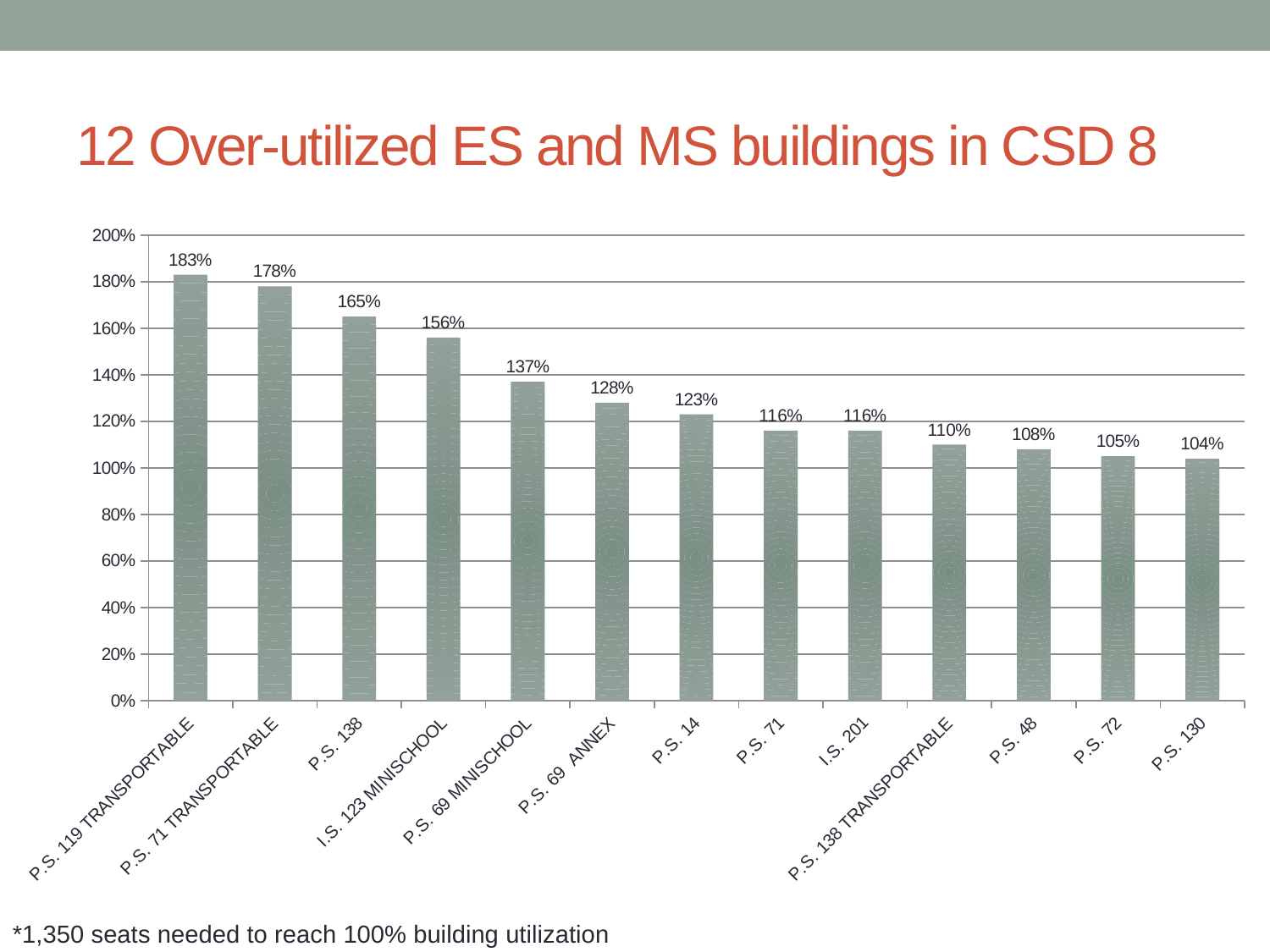
What is the difference between the utilization of P.S. 119 TRANSPORTABLE and P.S. 71 TRANSPORTABLE? 5% Which building has the lowest utilization? P.S. 130 Is the value for P.S. 138 TRANSPORTABLE greater or less than 120%? less What is the utilization value for P.S. 48? 108% What is the utilization value for P.S. 69 ANNEX? 128% What kind of chart is shown on the slide? Bar chart What is the difference between the utilization of I.S. 123 MINISCHOOL and P.S. 69 MINISCHOOL? 19% What is the utilization value for P.S. 138? 165% How many buildings are shown in the chart? 13 Which has a higher utilization, P.S. 14 or P.S. 72? P.S. 14 Which building has the highest utilization? P.S. 119 TRANSPORTABLE Do the values rise or fall from left to right along the x axis? Fall